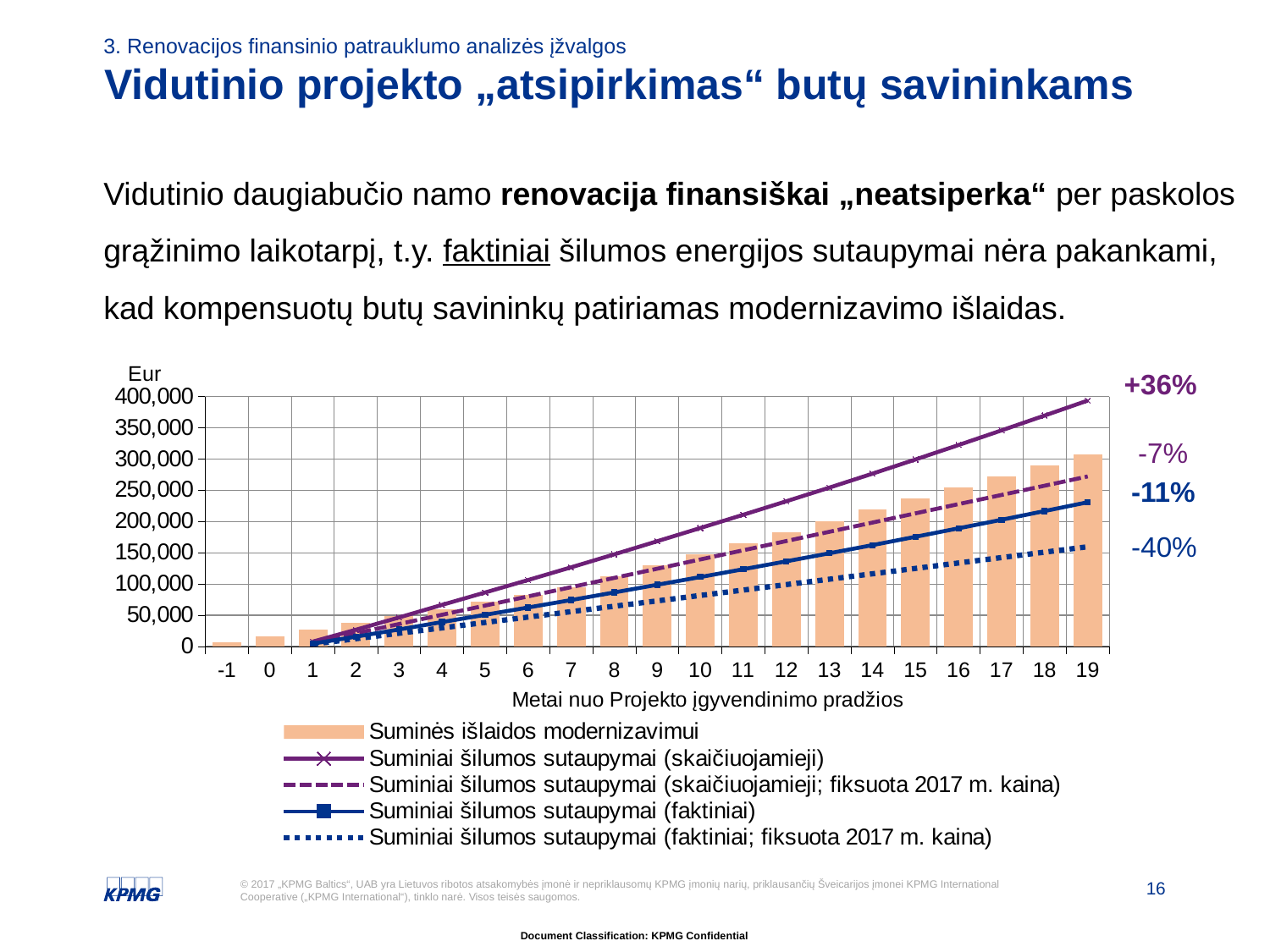
What kind of chart is shown on the slide? Combined bar and line chart How many series does the chart legend list? 5 At year 19, which is higher: the Suminės išlaidos modernizavimui bar or the Suminiai šilumos sutaupymai (faktiniai) line? Suminės išlaidos modernizavimui Do the bars for Suminės išlaidos modernizavimui rise or fall as the years increase along the x axis? Rise Is the value of Suminiai šilumos sutaupymai (skaičiuojamieji) at year 19 greater or less than 350,000? greater Which year has the tallest bar for Suminės išlaidos modernizavimui? 19 How many years (categories) are shown on the x axis of the chart? 21 At year 19, which is higher: the Suminiai šilumos sutaupymai (skaičiuojamieji) line or the Suminės išlaidos modernizavimui bar? Suminiai šilumos sutaupymai (skaičiuojamieji) Is the value of Suminiai šilumos sutaupymai (faktiniai; fiksuota 2017 m. kaina) at year 19 greater or less than 200,000? less Is the value of the Suminės išlaidos modernizavimui bar at year 10 greater or less than 100,000? greater What is the title of the x axis of the chart? Metai nuo Projekto įgyvendinimo pradžios